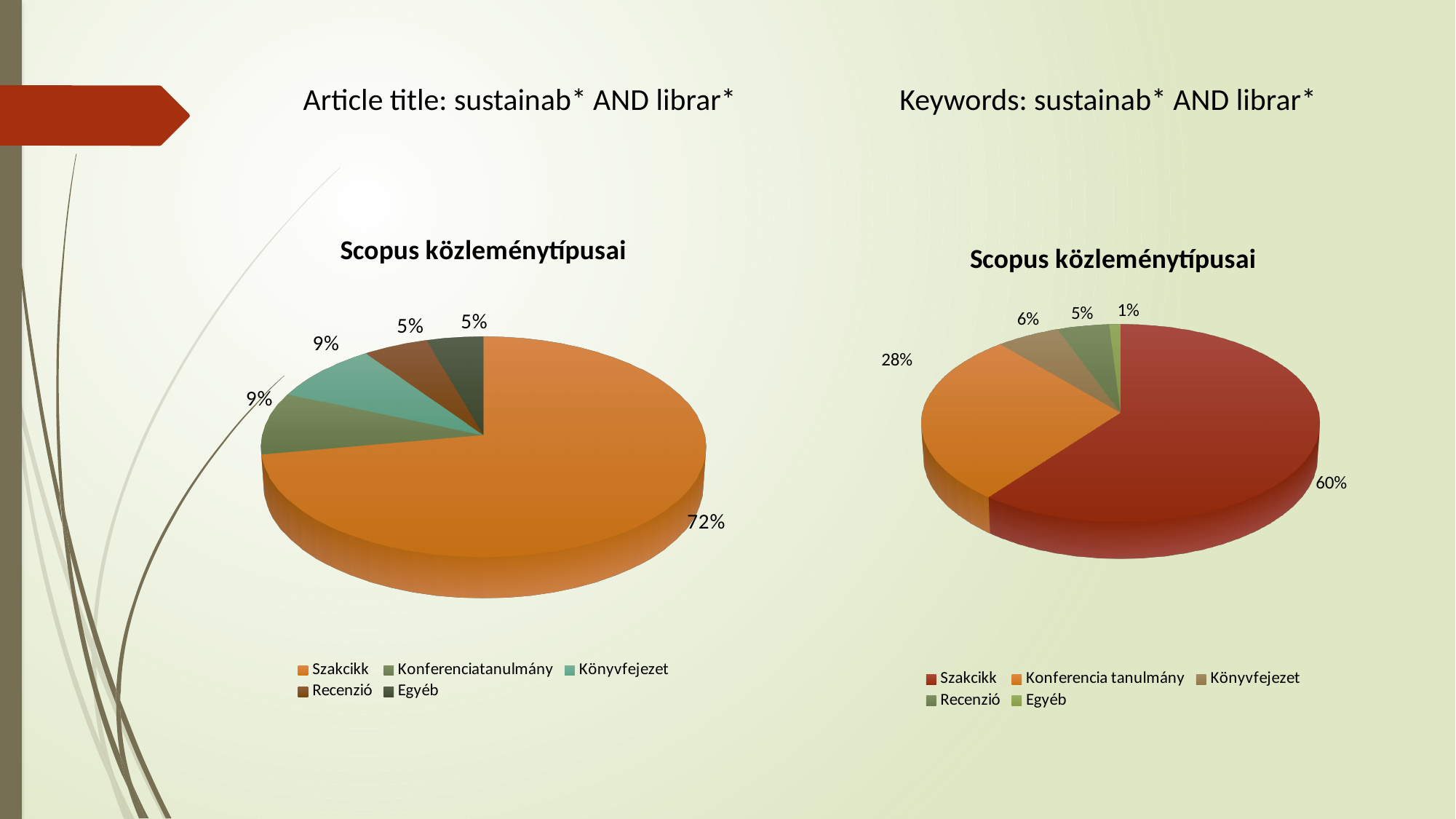
In the left pie chart (Article title: sustainab* AND librar*), what share does Szakcikk have? 72% In the right pie chart (Keywords: sustainab* AND librar*), what is the difference between the shares of Szakcikk and Konferencia tanulmány? 32% What type of chart is used on the right side of the slide (Keywords: sustainab* AND librar*)? Pie chart Which chart shows a larger share for Szakcikk, the left chart (Article title) or the right chart (Keywords)? The left chart (Article title) In the right pie chart (Keywords: sustainab* AND librar*), which category has the smallest share? Egyéb In the right pie chart (Keywords: sustainab* AND librar*), what share does Konferencia tanulmány have? 28% In the right pie chart (Keywords: sustainab* AND librar*), what share does Szakcikk have? 60% What is the title of the left chart (Article title: sustainab* AND librar*)? Scopus közleménytípusai In the left pie chart (Article title: sustainab* AND librar*), which category has the largest share? Szakcikk How many categories does the legend of the left pie chart (Article title: sustainab* AND librar*) list? 5 In the right pie chart (Keywords: sustainab* AND librar*), what share does Egyéb have? 1% In the left pie chart (Article title: sustainab* AND librar*), what share does Könyvfejezet have? 9%